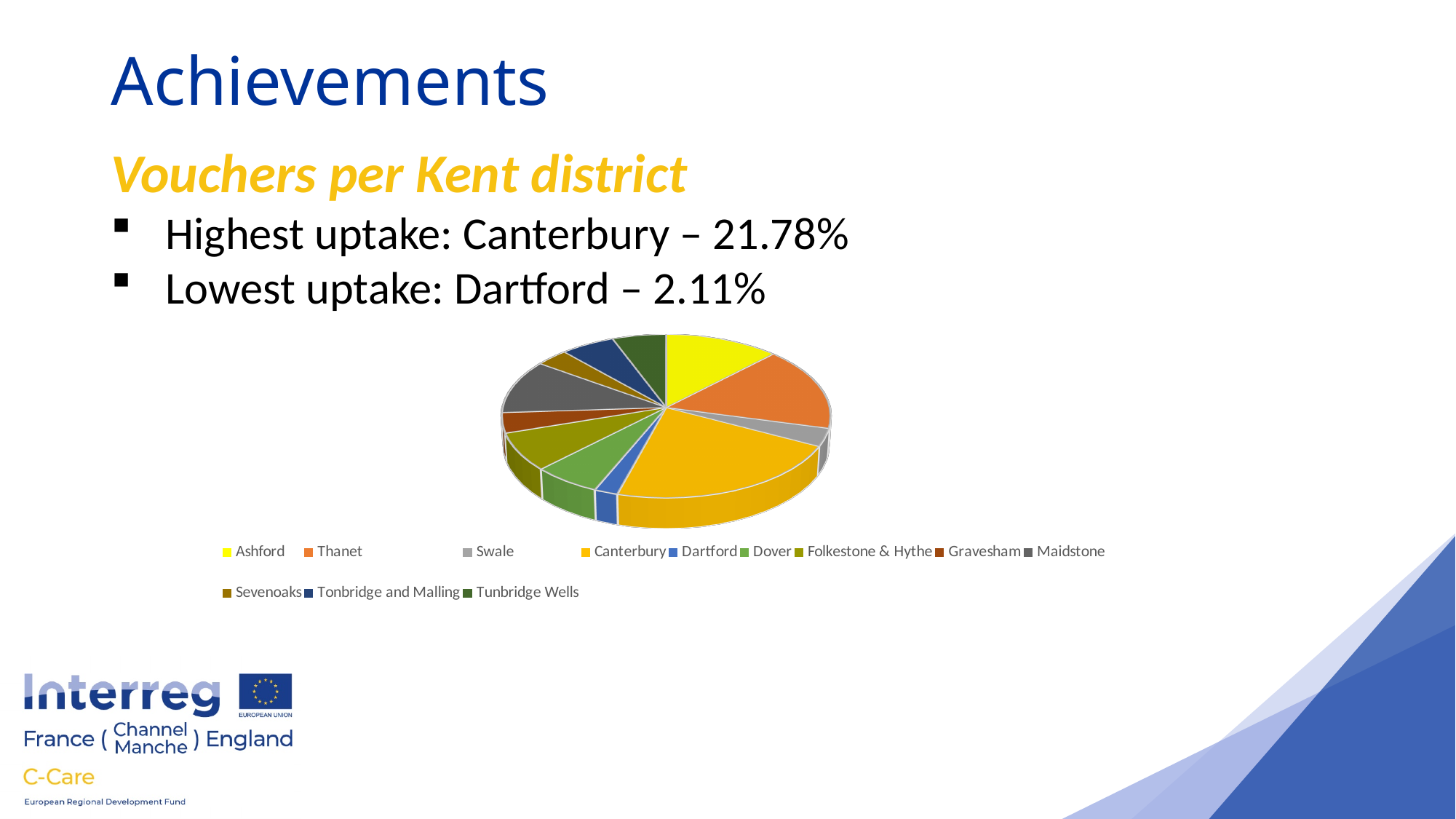
How many districts (categories) does the pie chart's legend list? 12 What share of vouchers does Canterbury have, according to the slide? 21.78% Which slice is larger in the pie chart, Thanet or Swale? Thanet Which slice is larger in the pie chart, Maidstone or Gravesham? Maidstone Which district has the largest slice of the pie chart? Canterbury Which slice is larger in the pie chart, Canterbury or Ashford? Canterbury What share of vouchers does Dartford have, according to the slide? 2.11% What is the heading shown above the pie chart? Vouchers per Kent district What is the difference between Canterbury's uptake and Dartford's uptake? 19.67% What colour is the Thanet slice in the pie chart? orange Which district has the smallest slice of the pie chart? Dartford What kind of chart is shown on the slide? pie chart